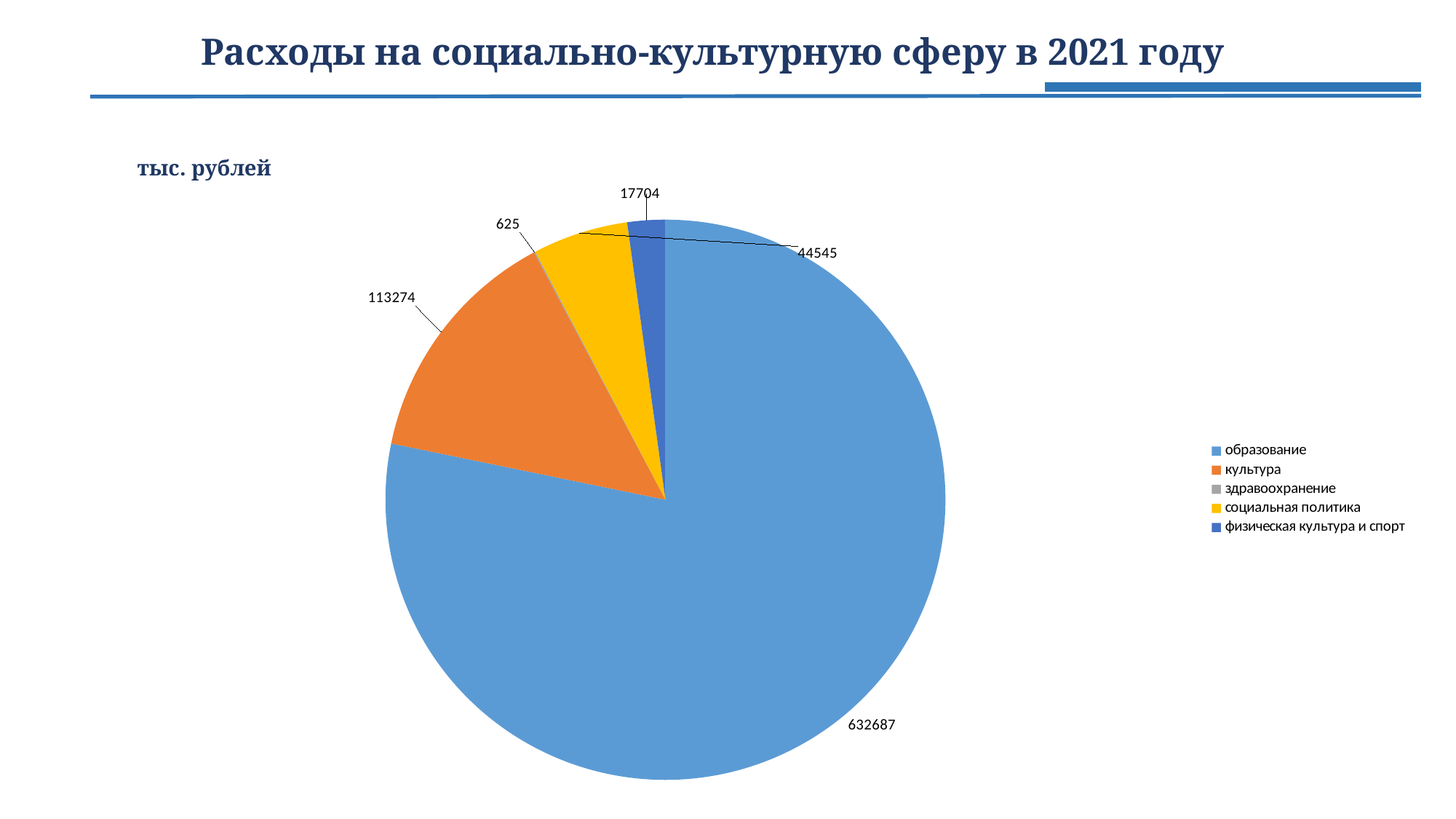
What is the difference between the values for социальная политика and физическая культура и спорт? 26841 What kind of chart is shown on the slide? pie chart How many categories does the legend list? 5 Which is larger, the value for культура or the value for социальная политика? культура Which category has the largest slice of the pie? образование What is the value for культура? 113274 What is the difference between the values for культура and социальная политика? 68729 What is the value for образование? 632687 What is the value for здравоохранение? 625 Which category has the smallest slice of the pie? здравоохранение What is the value for физическая культура и спорт? 17704 What is the value for социальная политика? 44545